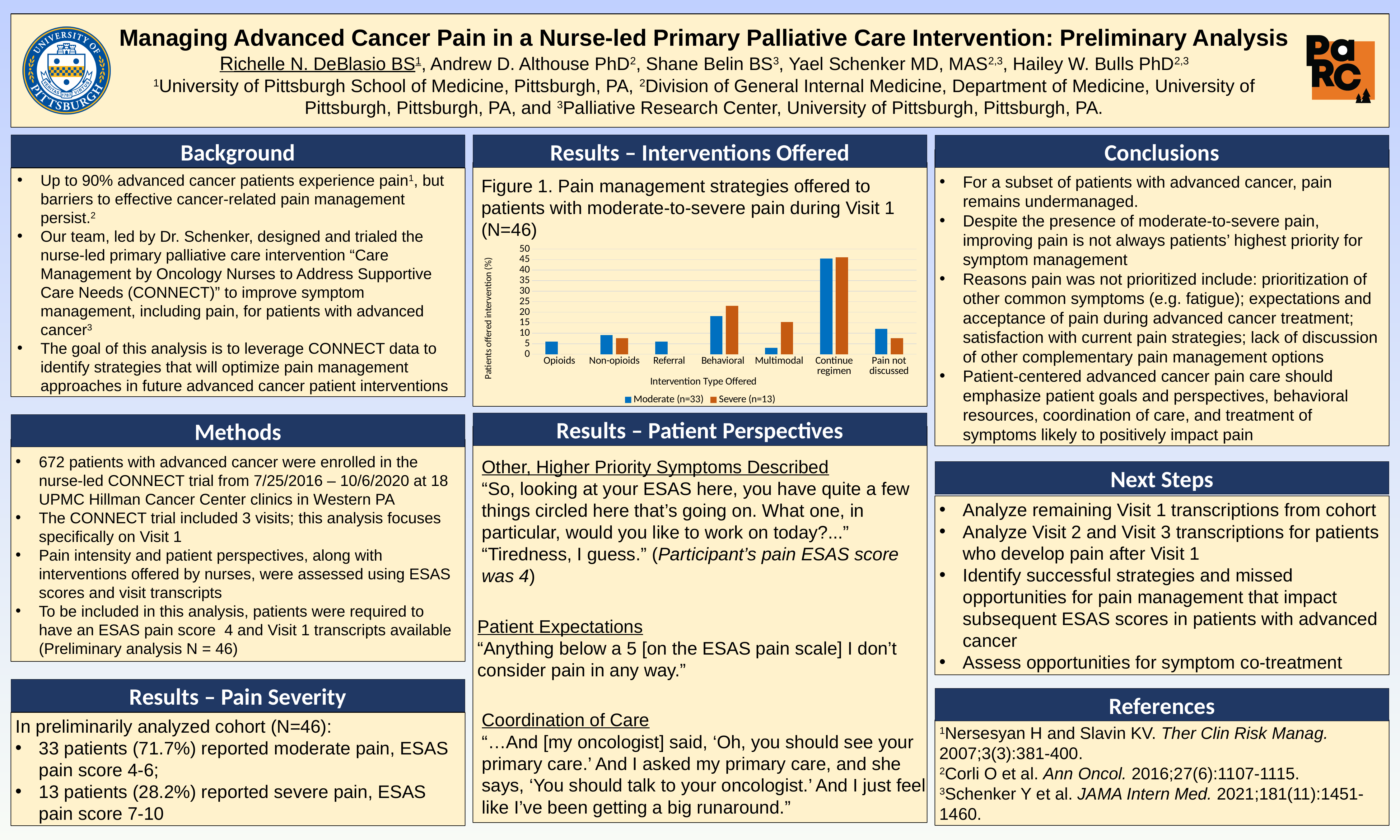
How many intervention type categories are shown on the x axis of the chart? 7 For Pain not discussed, which series has the larger value, Moderate (n=33) or Severe (n=13)? Moderate (n=33) What kind of chart is shown in Figure 1? bar chart What is the label of the x axis of the chart? Intervention Type Offered For Multimodal, which series has the larger value, Moderate (n=33) or Severe (n=13)? Severe (n=13) How many series does the chart legend list? 2 Is the Moderate (n=33) value for Multimodal greater or less than 5? less Which intervention type has the highest value for the Moderate (n=33) series? Continue regimen Which intervention type has the highest value for the Severe (n=13) series? Continue regimen What is the label of the y axis of the chart? Patients offered intervention (%) Is the Moderate (n=33) value for Continue regimen greater or less than 40? greater Is the Severe (n=13) value for Behavioral greater or less than 20? greater